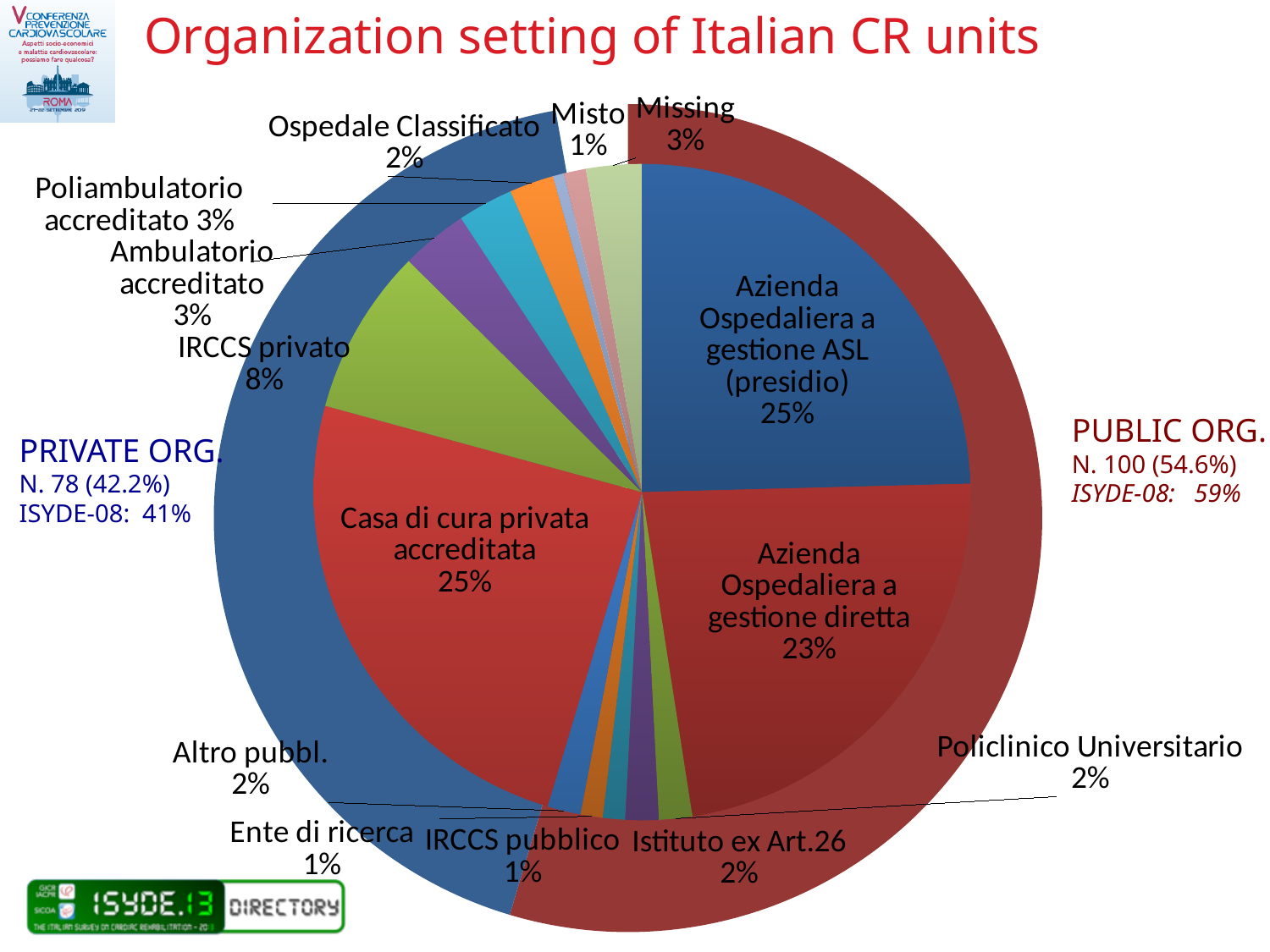
According to the annotation on the slide, how many units are in the PUBLIC ORG. group? N. 100 (54.6%) What share of the pie is Missing? 3% What share of the pie is Azienda Ospedaliera a gestione diretta? 23% What share of the pie is Misto? 1% What kind of chart is shown on the slide? Pie chart Which is larger, Azienda Ospedaliera a gestione diretta or IRCCS privato? Azienda Ospedaliera a gestione diretta What is the title of the chart? Organization setting of Italian CR units What is the difference in percentage points between Azienda Ospedaliera a gestione diretta and IRCCS privato? 15 percentage points How many slices are labelled in the pie chart? 14